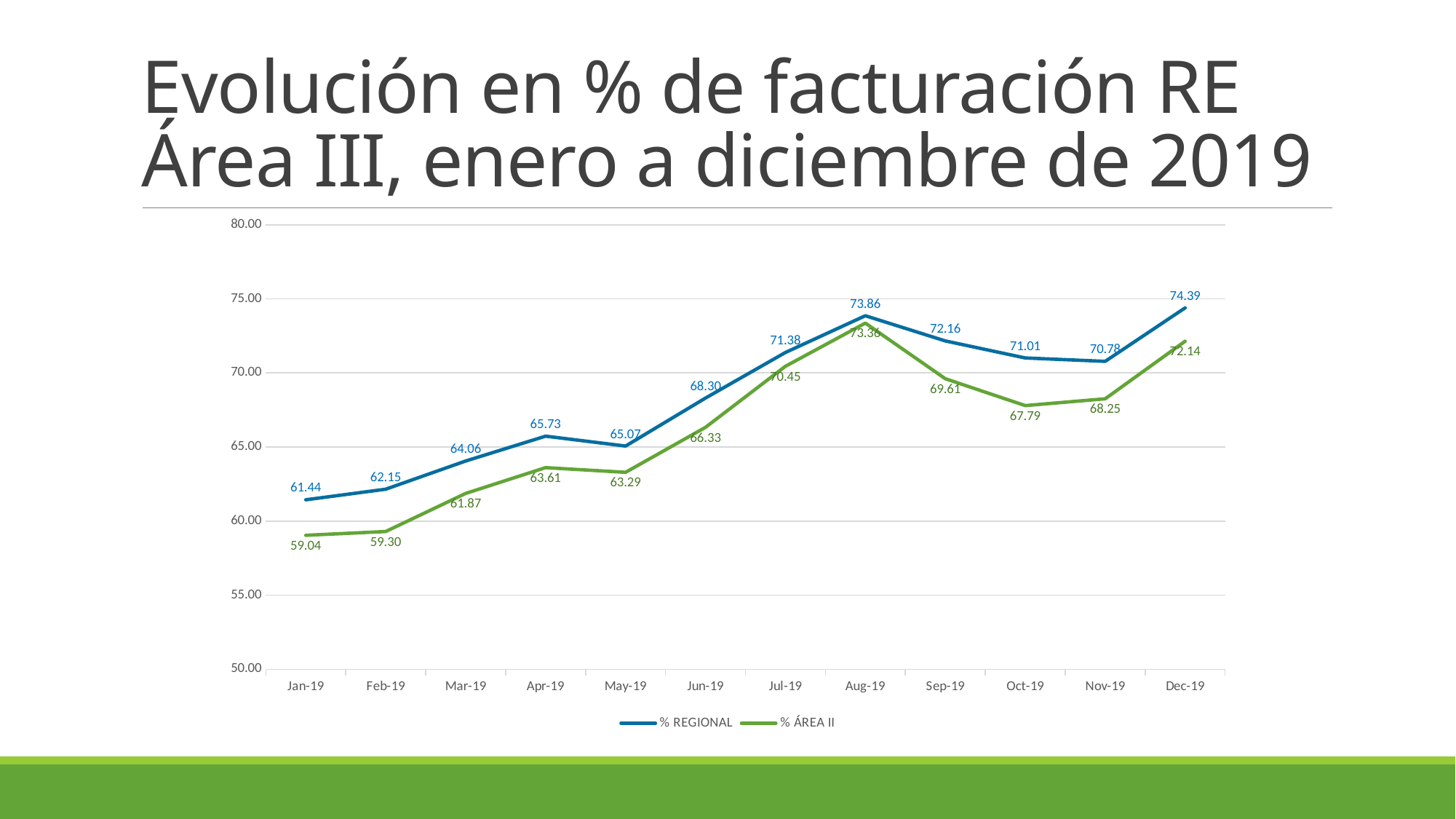
What type of chart is shown on the slide? line chart How many months are plotted along the x axis? 12 Which is larger in Jul-19, the % REGIONAL value or the % ÁREA II value? % REGIONAL Which series is drawn in green? % ÁREA II What is the difference between the % REGIONAL and % ÁREA II values in Oct-19? 3.22 What is the % REGIONAL value for Aug-19? 73.86 How many series does the legend list? 2 In which month is the % ÁREA II series at its lowest value? Jan-19 What is the % ÁREA II value for Jan-19? 59.04 Is the % ÁREA II value for Sep-19 greater or less than 70.00? less What is the % REGIONAL value for Dec-19? 74.39 In which month does the % REGIONAL series reach its highest value? Dec-19